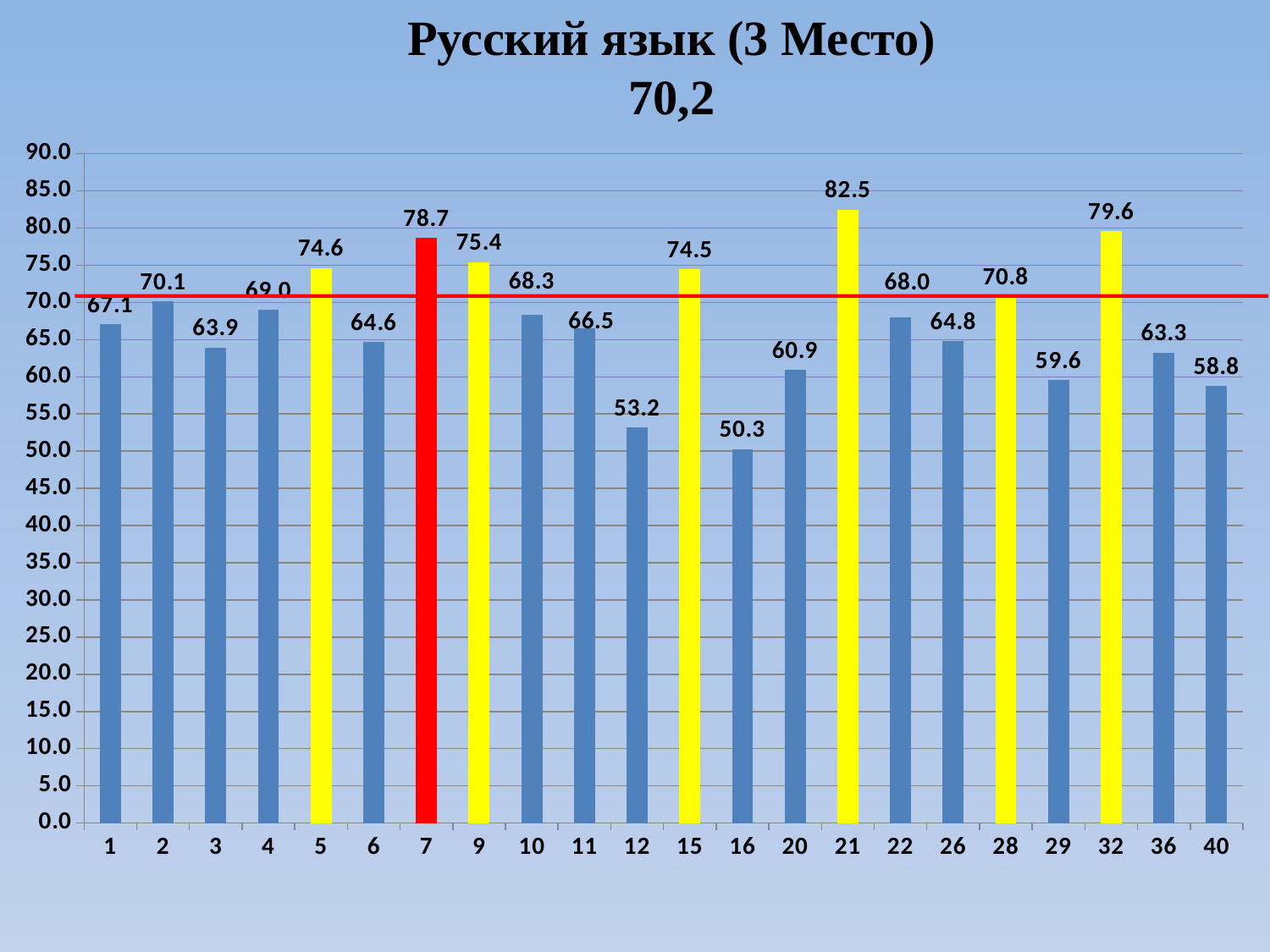
Which category has the lowest value? 16 What is the value for category 7? 78.7 Which has a larger value, category 32 or category 9? 32 What is the difference between the values for category 7 and category 9? 3.3 What is the difference between the values for category 21 and category 16? 32.2 What colour is the bar for category 7? red How many categories are shown on the x axis? 22 What kind of chart is shown on the slide? bar chart What is the value for category 40? 58.8 Which category has the highest value? 21 Is the value for category 12 greater or less than 55? less What is the value for category 21? 82.5